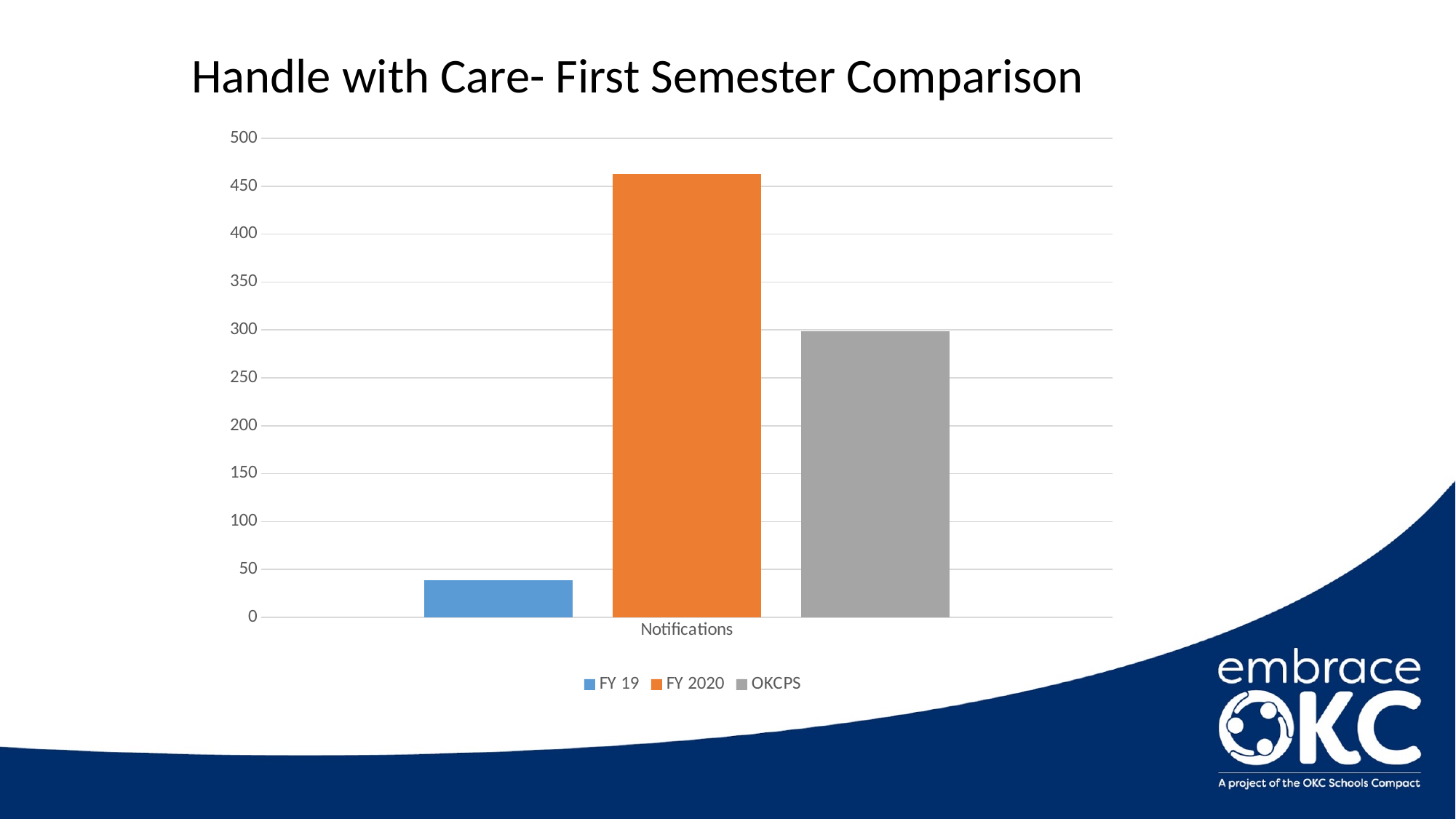
What is the category label on the x axis? Notifications What kind of chart is shown on the slide? bar chart Is the value for FY 19 greater or less than 50? less What is the title of the chart? Handle with Care- First Semester Comparison Is the value for OKCPS greater or less than 250? greater How many categories are shown on the x axis? 1 Which series has the lowest value for Notifications? FY 19 Which is larger for Notifications, FY 19 or OKCPS? OKCPS Which is larger for Notifications, FY 2020 or OKCPS? FY 2020 How many series does the legend list? 3 Is the value for FY 2020 greater or less than 450? greater Which series has the highest value for Notifications? FY 2020